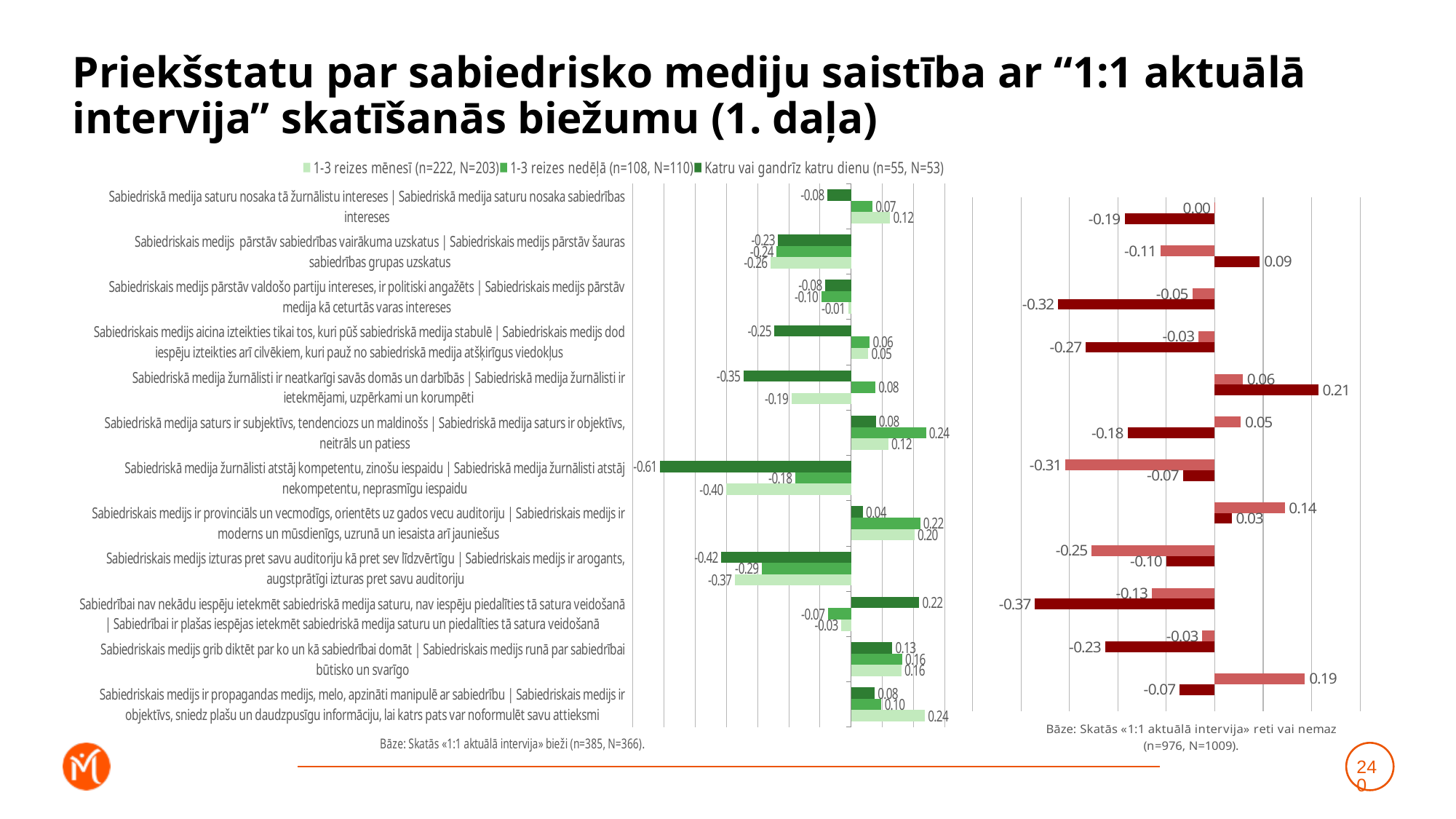
In the left chart, which category has the lowest value for the "Katru vai gandrīz katru dienu" series? Sabiedriskā medija žurnālisti atstāj kompetentu, zinošu iespaidu | Sabiedriskā medija žurnālisti atstāj nekompetentu, neprasmīgu iespaidu In the right chart, for the category "Sabiedriskais medijs ir provinciāls un vecmodīgs, ...", which is larger: the light red bar or the dark red bar? The light red bar (0.14) In the left chart, for the category "Sabiedriskā medija saturs ir subjektīvs, tendenciozs un maldinošs | ...", what is the difference between the "1-3 reizes nedēļā" value and the "1-3 reizes mēnesī" value? 0.12 In the left chart, what is the value of the "1-3 reizes nedēļā" series for the category "Sabiedriskā medija saturs ir subjektīvs, tendenciozs un maldinošs | ... objektīvs, neitrāls un patiess"? 0.24 How many series does the legend of the left chart list? 3 What type of chart is the left chart? Bar chart In the right chart, what is the value of the dark red bar for the category "Sabiedriskā medija žurnālisti ir neatkarīgi savās domās un darbībās | ..."? 0.21 How many categories are shown in the left chart? 12 In the left chart, what is the value of the "1-3 reizes mēnesī" series for the category "Sabiedriskais medijs ir propagandas medijs, melo, apzināti manipulē ar sabiedrību | ..."? 0.24 In the left chart, what is the value of the "Katru vai gandrīz katru dienu" series for the category "Sabiedriskā medija žurnālisti atstāj kompetentu, zinošu iespaidu | ... nekompetentu, neprasmīgu iespaidu"? -0.61